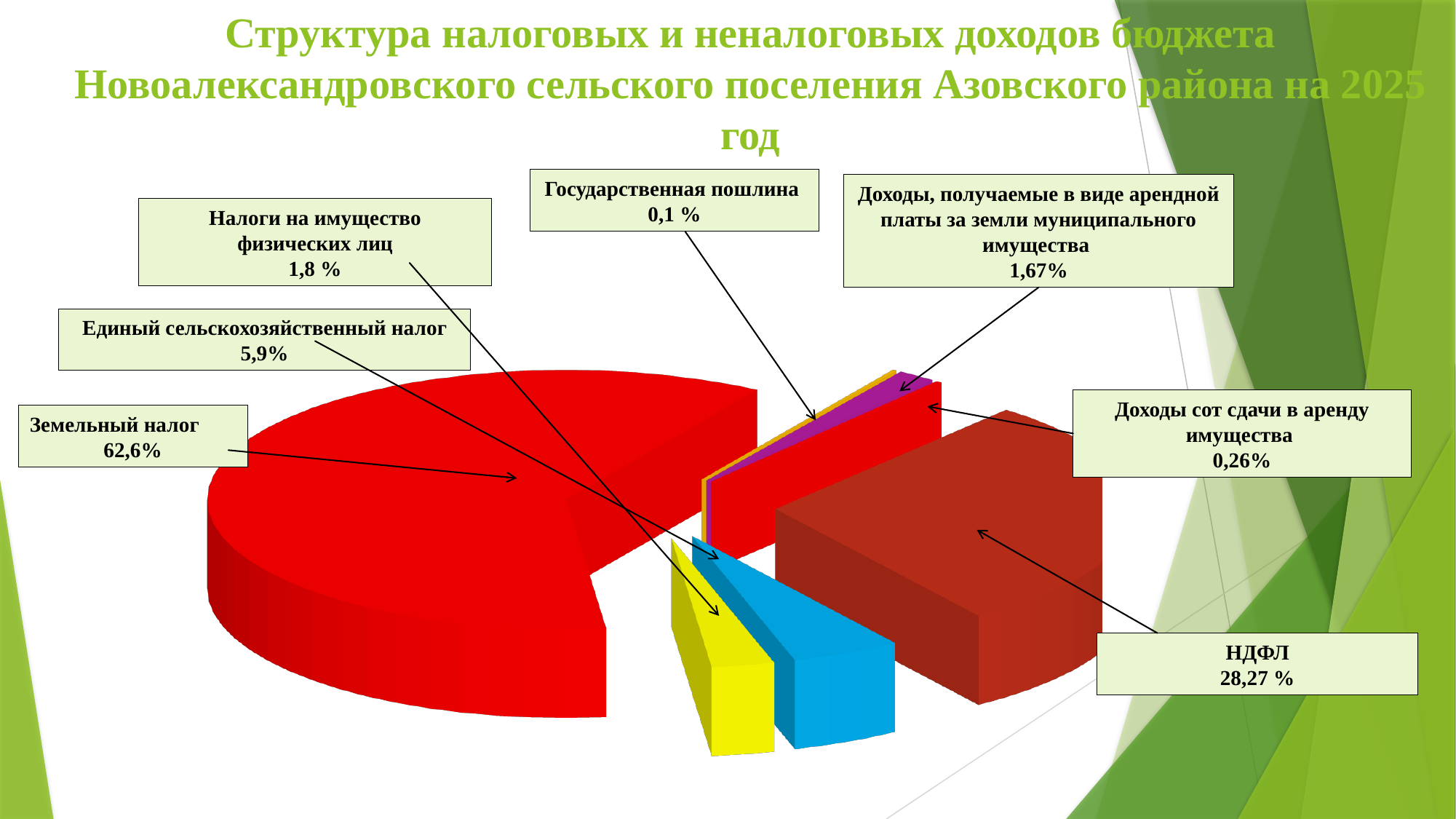
What is the value shown for Доходы, получаемые в виде арендной платы за земли муниципального имущества? 1,67% What is the value shown for НДФЛ? 28,27 % How many categories (slices) are labelled on the pie chart? 7 Which category has the smallest share of the pie? Государственная пошлина What is the difference in percentage points between Земельный налог and НДФЛ? 34,33 What is the value shown for Единый сельскохозяйственный налог? 5,9% Which category has the largest share of the pie? Земельный налог What share of the budget revenue does Земельный налог account for? 62,6% What is the value shown for Государственная пошлина? 0,1 % What type of chart is shown on the slide? pie chart What colour is the slice representing Земельный налог? red Which is larger: Налоги на имущество физических лиц or Единый сельскохозяйственный налог? Единый сельскохозяйственный налог